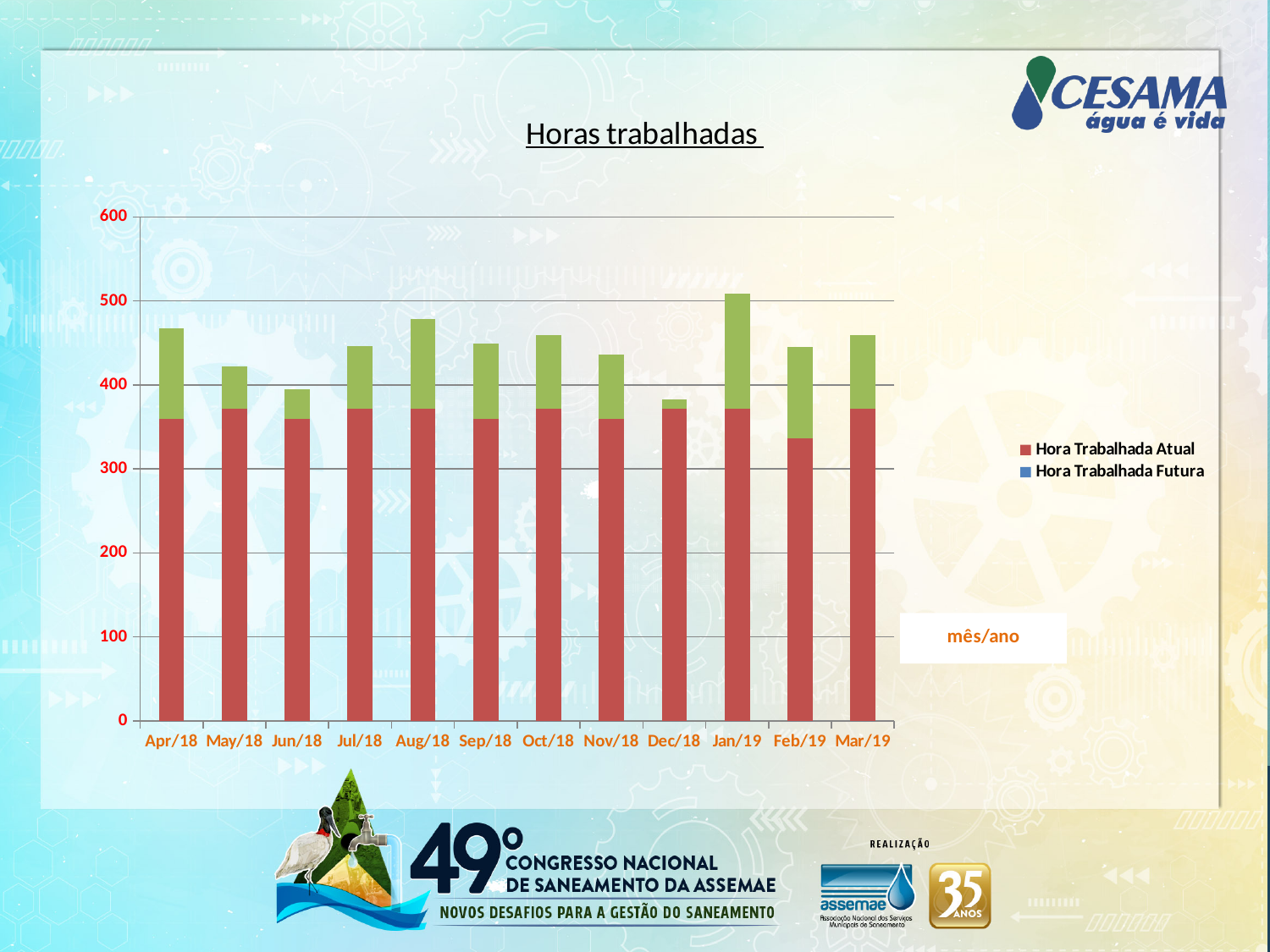
Which has the larger total stacked bar, Aug/18 or May/18? Aug/18 How many months are shown on the x axis of the chart? 12 How many series does the legend of the chart list? 2 Which has the larger total stacked bar, Jan/19 or Dec/18? Jan/19 Is the total stacked bar for Jan/19 greater or less than 500? greater What kind of chart is shown on the slide? bar chart Which month has the tallest stacked bar in the chart? Jan/19 Is the total stacked bar for Apr/18 greater or less than 400? greater Is the Hora Trabalhada Atual value for Feb/19 greater or less than 300? greater What is the title of the chart? Horas trabalhadas